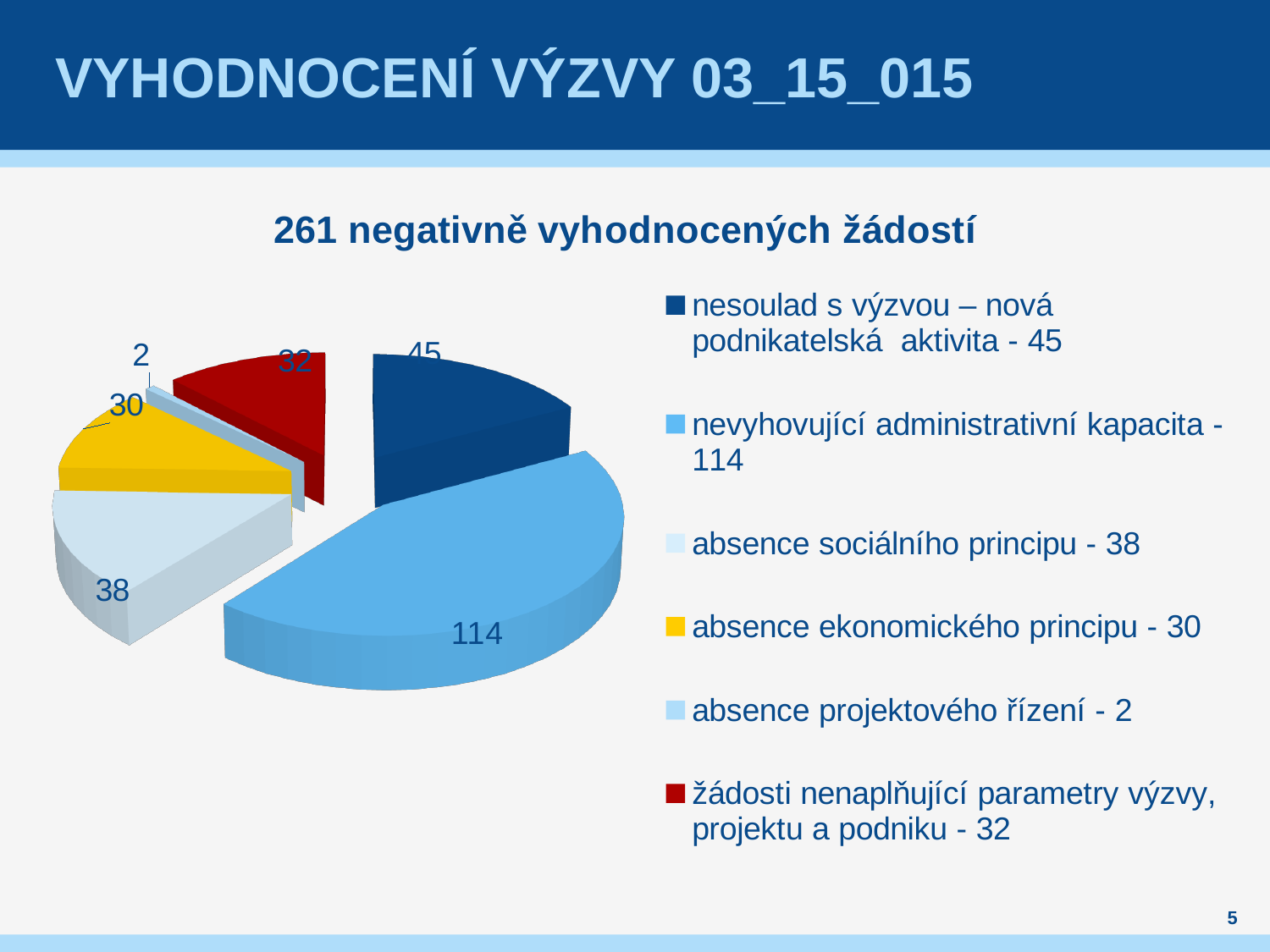
Which is larger: 'absence sociálního principu' or 'žádosti nenaplňující parametry výzvy, projektu a podniku'? absence sociálního principu Which category has the largest slice of the pie? nevyhovující administrativní kapacita What is the value for 'nesoulad s výzvou – nová podnikatelská aktivita'? 45 What kind of chart is shown on the slide? pie chart Which category has the smallest slice of the pie? absence projektového řízení What is the difference between 'absence sociálního principu' and 'žádosti nenaplňující parametry výzvy, projektu a podniku'? 6 How many categories does the pie chart show? 6 What is the difference between 'nevyhovující administrativní kapacita' and 'nesoulad s výzvou – nová podnikatelská aktivita'? 69 How many applications fall under 'nevyhovující administrativní kapacita'? 114 What is the title shown above the pie chart? 261 negativně vyhodnocených žádostí What is the value for 'absence ekonomického principu'? 30 What is the total of all slices in the pie chart? 261